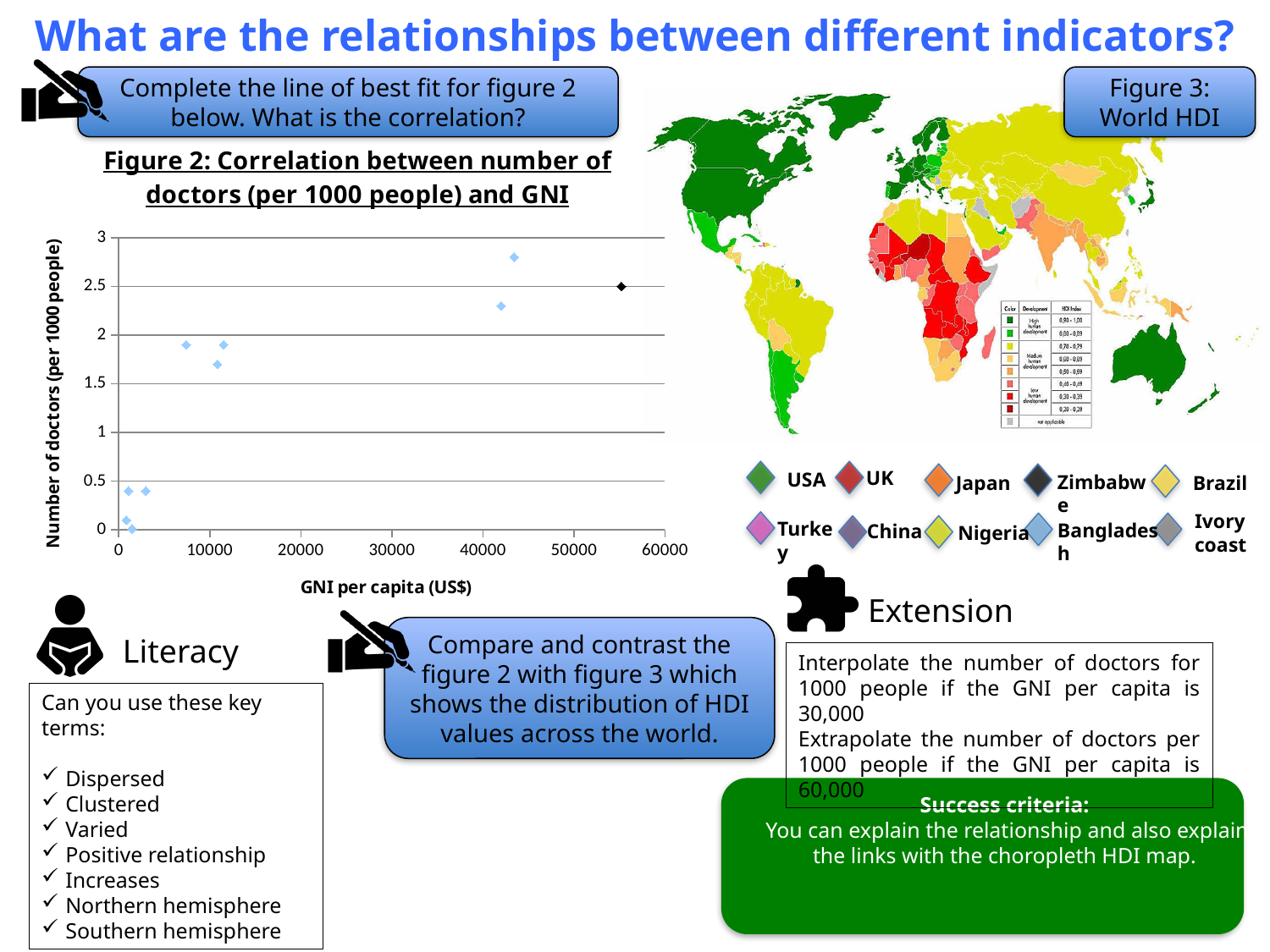
In Figure 2, do the number of doctors generally rise or fall as GNI per capita increases? Rise What is the maximum value shown on the x axis of Figure 2? 60000 In Figure 2, are the number of doctors for the points with GNI per capita around 10000 greater or less than 2? less What kind of chart is Figure 2? Scatter chart In Figure 2, is the number of doctors for the highest plotted point greater or less than 2.5? greater In Figure 2, is the number of doctors for the point with the highest GNI per capita (around 55000) greater or less than 2? greater How many data points are plotted in Figure 2? 10 In Figure 2, what is the title of the x axis? GNI per capita (US$) In Figure 2, what is the title of the y axis? Number of doctors (per 1000 people)